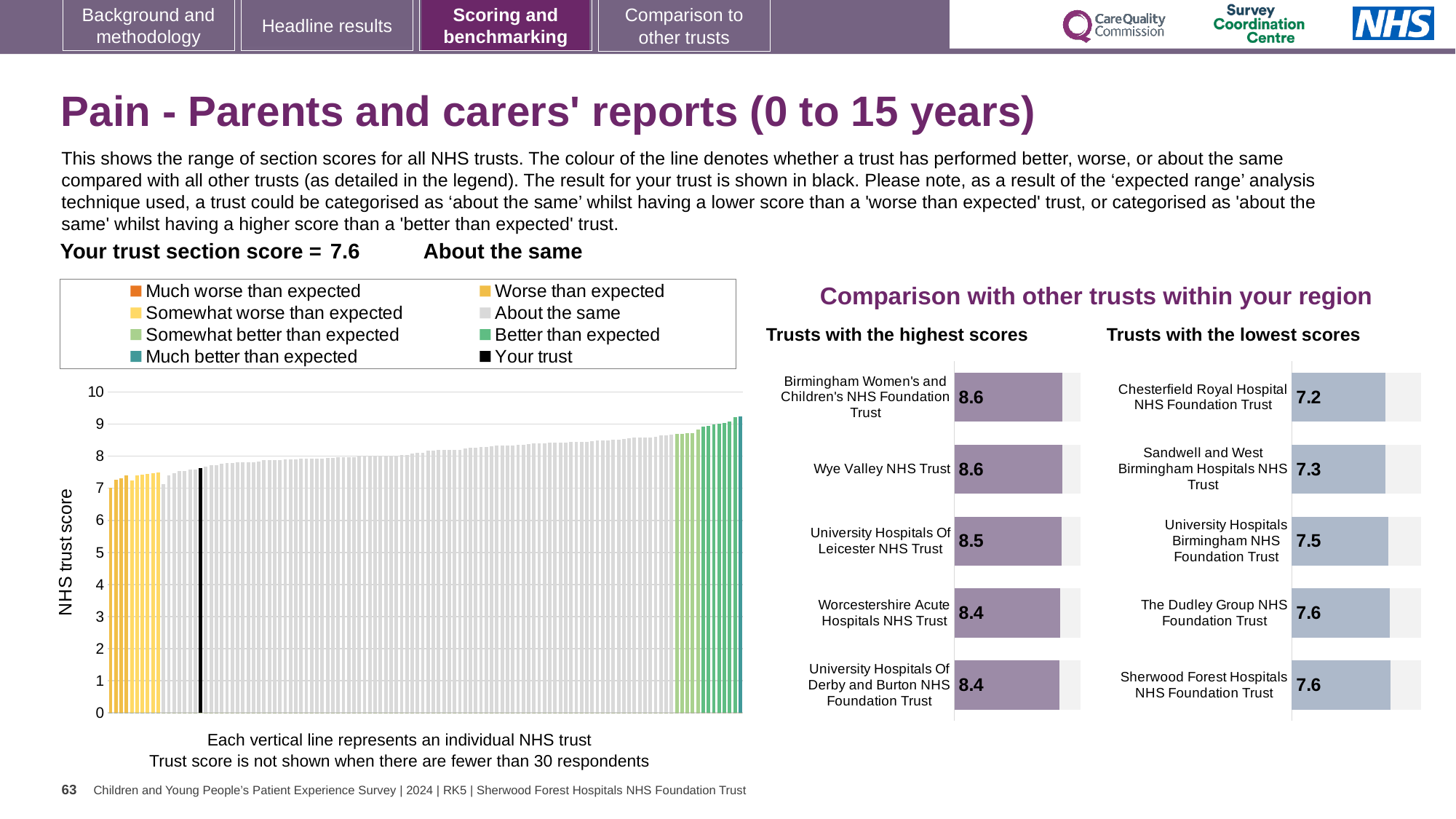
In the 'Trusts with the highest scores' chart, what is the score for University Hospitals Of Leicester NHS Trust? 8.5 What is the difference between the score for Birmingham Women's and Children's NHS Foundation Trust in the 'Trusts with the highest scores' chart and the score for Chesterfield Royal Hospital NHS Foundation Trust in the 'Trusts with the lowest scores' chart? 1.4 In the large chart on the left, what is the label on the vertical axis? NHS trust score What kind of chart is the large chart on the left showing all NHS trusts? bar chart In the large chart on the left, do the bar heights rise or fall from left to right? rise How many trusts are shown in the 'Trusts with the highest scores' chart? 5 In the large chart on the left, is the value of the black bar (your trust) greater or less than 7? greater In the 'Trusts with the lowest scores' chart, what is the score for Sherwood Forest Hospitals NHS Foundation Trust? 7.6 In the 'Trusts with the highest scores' chart, what is the score for Wye Valley NHS Trust? 8.6 How many entries does the legend above the large chart on the left list? 8 In the 'Trusts with the lowest scores' chart, which has the larger score: Sandwell and West Birmingham Hospitals NHS Trust or University Hospitals Birmingham NHS Foundation Trust? University Hospitals Birmingham NHS Foundation Trust In the 'Trusts with the lowest scores' chart, which trust has the lowest score? Chesterfield Royal Hospital NHS Foundation Trust